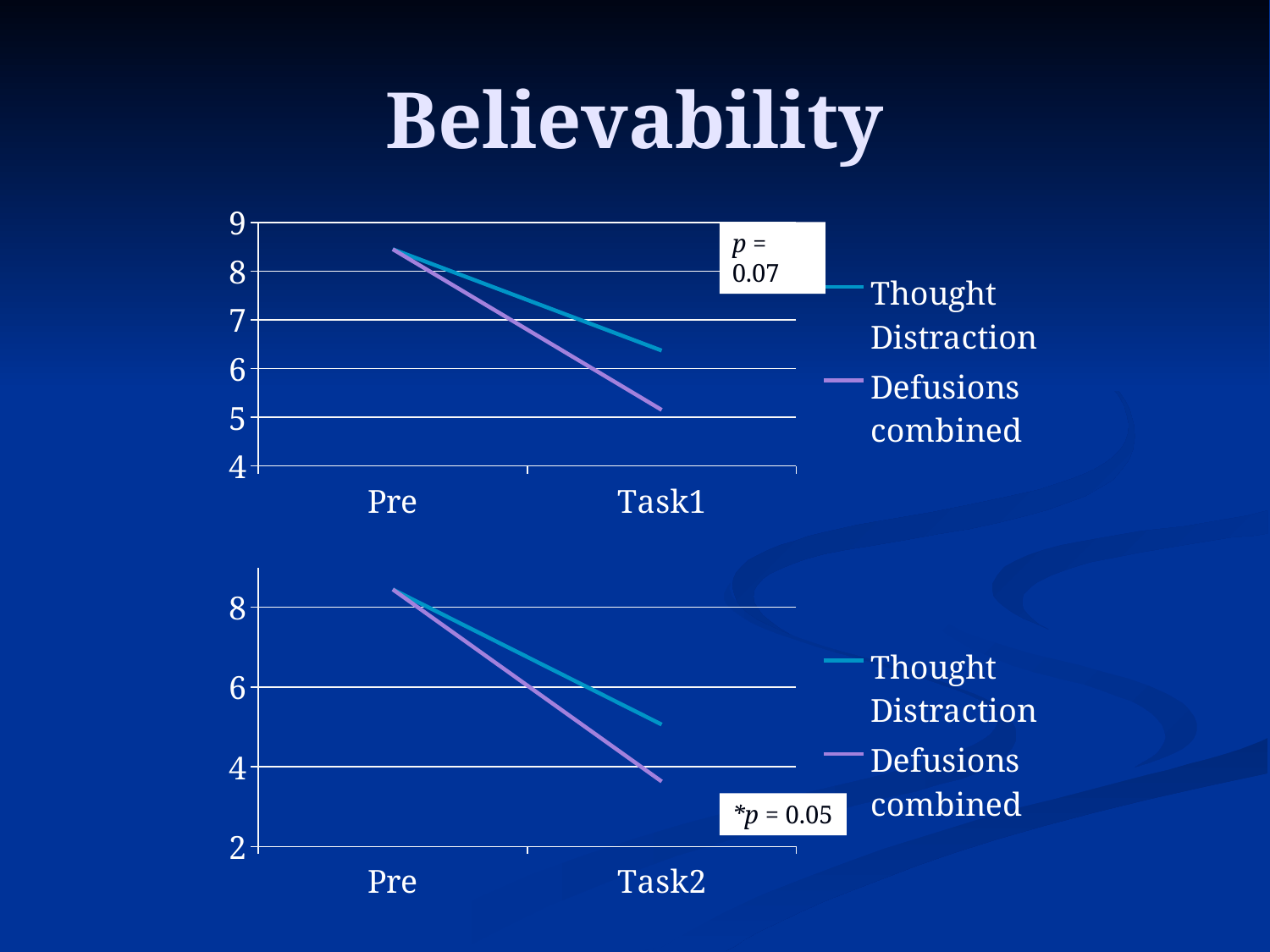
In the bottom chart, do the values for Thought Distraction rise or fall from Pre to Task2? fall In the bottom chart, is the value for Defusions combined at Task2 greater or less than 4? less How many series does the legend of the top chart list? 2 In the top chart, which series has the larger value at Task1, Thought Distraction or Defusions combined? Thought Distraction In the top chart, is the value for Defusions combined at Task1 greater or less than 6? less What kind of chart is the top chart on the slide? line chart How many categories are on the x axis of the bottom chart? 2 In the top chart, do the values for Defusions combined rise or fall from Pre to Task1? fall What p value is annotated on the bottom chart? *p = 0.05 In the bottom chart, which series has the lower value at Task2? Defusions combined In the bottom chart, is the value for Thought Distraction at Task2 greater or less than 4? greater